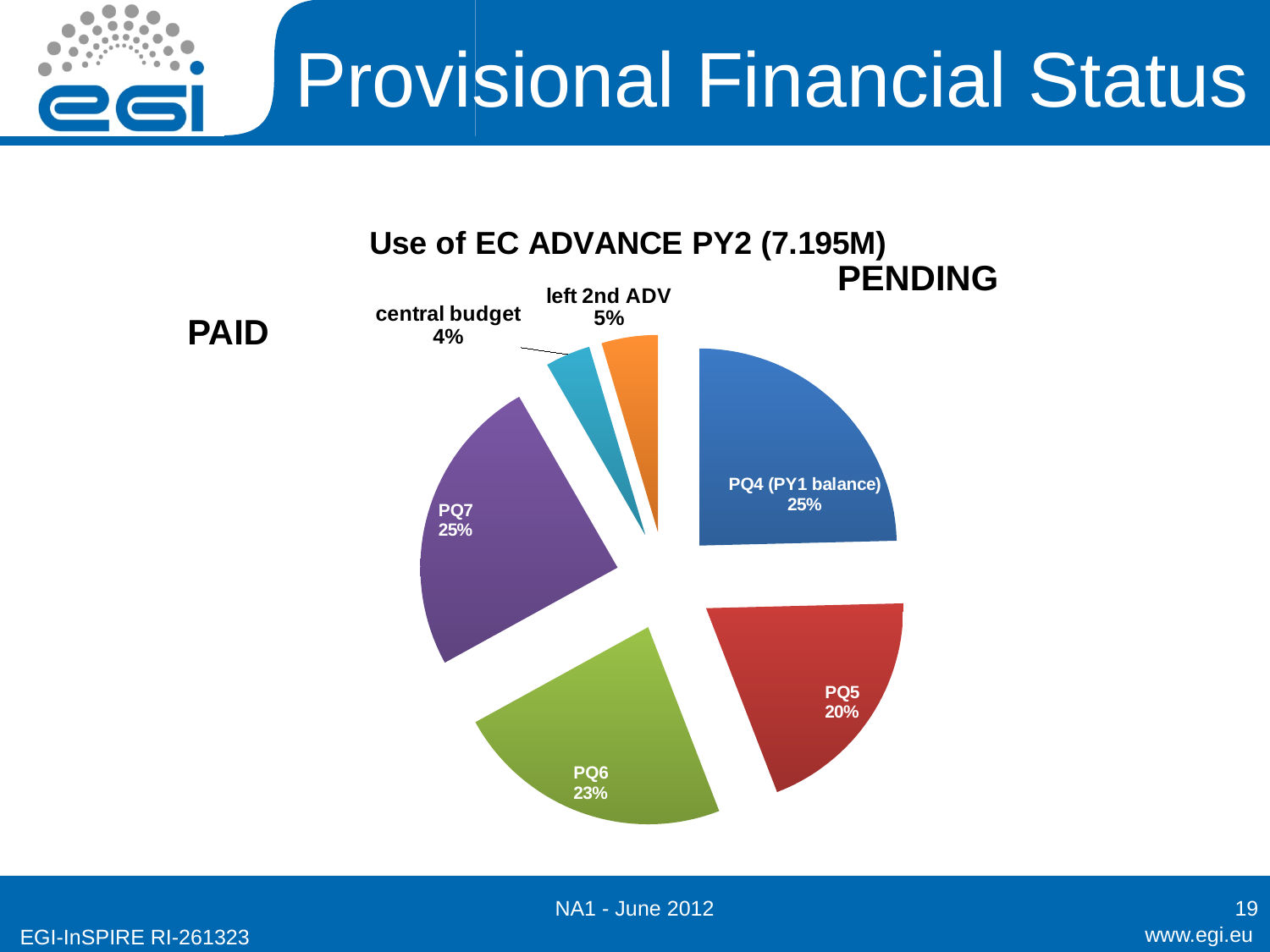
What is the difference in percentage points between the PQ6 share and the PQ5 share? 3 What kind of chart is shown on the slide? Pie chart What percentage is shown for central budget? 4% What share of the pie does PQ6 represent? 23% What share of the pie does PQ4 (PY1 balance) represent? 25% What is the title of the chart? Use of EC ADVANCE PY2 (7.195M) What share of the pie does PQ7 represent? 25% What percentage is shown for left 2nd ADV? 5% How many slices does the pie chart have? 6 Which is larger, the share for PQ6 or the share for PQ5? PQ6 Which slice has the smallest share of the pie? central budget